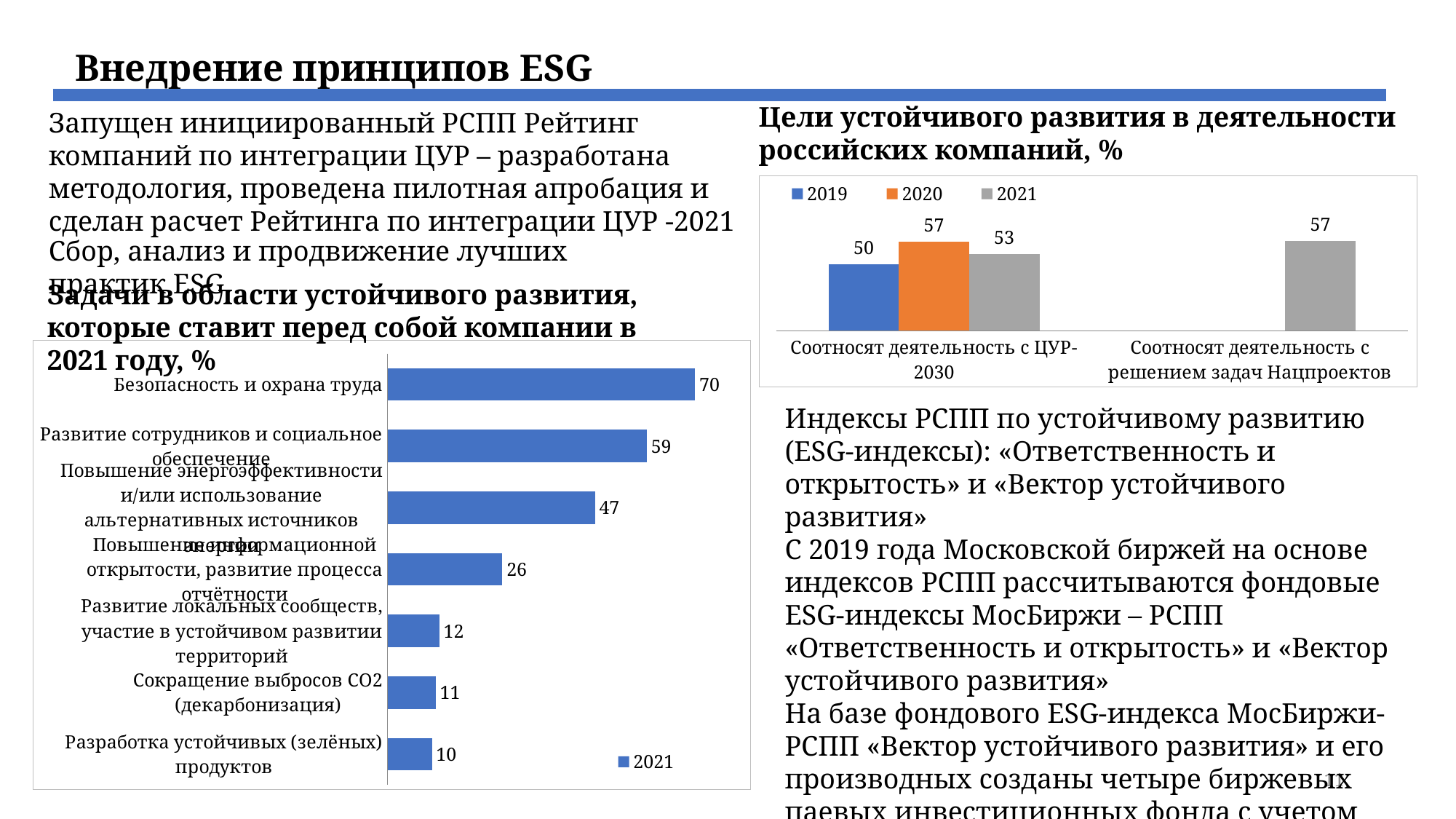
In the chart 'Задачи в области устойчивого развития, которые ставит перед собой компании в 2021 году, %', what is the difference between 'Безопасность и охрана труда' and 'Развитие сотрудников и социальное обеспечение'? 11 In the chart 'Цели устойчивого развития в деятельности российских компаний, %', what is the 2020 value for 'Соотносят деятельность с ЦУР-2030'? 57 In the chart 'Задачи в области устойчивого развития, которые ставит перед собой компании в 2021 году, %', what is the value for 'Безопасность и охрана труда'? 70 In the chart 'Цели устойчивого развития в деятельности российских компаний, %', what is the 2021 value for 'Соотносят деятельность с решением задач Нацпроектов'? 57 In the chart 'Цели устойчивого развития в деятельности российских компаний, %', how many series does the legend list? 3 In the chart 'Задачи в области устойчивого развития, которые ставит перед собой компании в 2021 году, %', how many categories are shown? 7 In the chart 'Задачи в области устойчивого развития, которые ставит перед собой компании в 2021 году, %', which category has the lowest value? Разработка устойчивых (зелёных) продуктов In the chart 'Задачи в области устойчивого развития, которые ставит перед собой компании в 2021 году, %', what is the value for 'Сокращение выбросов CO2 (декарбонизация)'? 11 What type of chart is 'Задачи в области устойчивого развития, которые ставит перед собой компании в 2021 году, %'? Bar chart In the chart 'Задачи в области устойчивого развития, которые ставит перед собой компании в 2021 году, %', which category has the highest value? Безопасность и охрана труда In the chart 'Цели устойчивого развития в деятельности российских компаний, %', which is larger for 'Соотносят деятельность с ЦУР-2030': the 2019 value or the 2021 value? 2021 In the chart 'Цели устойчивого развития в деятельности российских компаний, %', what is the difference between the 2020 and 2019 values for 'Соотносят деятельность с ЦУР-2030'? 7